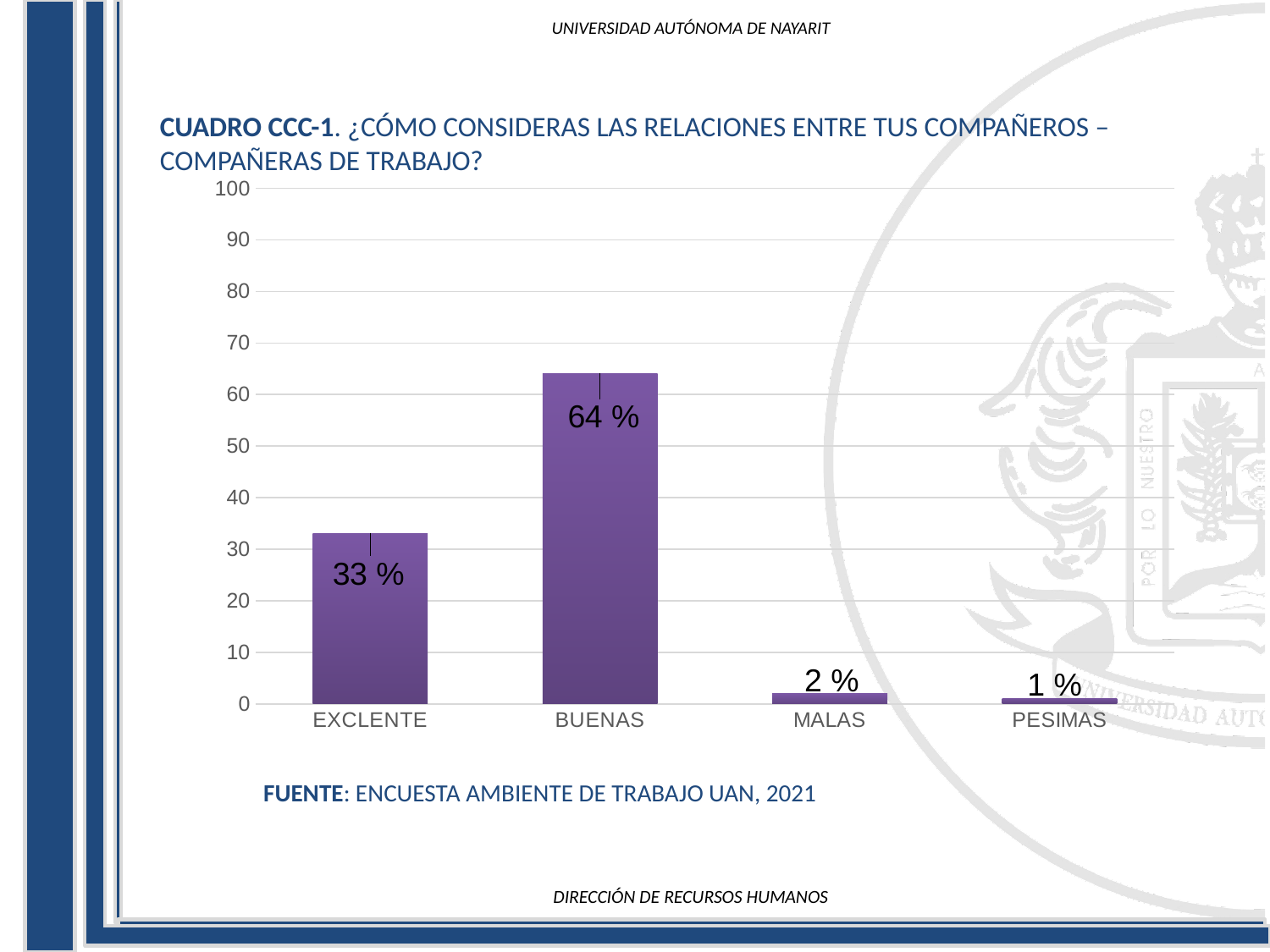
What is the value for MALAS? 2 % What source is cited below the chart? ENCUESTA AMBIENTE DE TRABAJO UAN, 2021 What is the value for EXCLENTE? 33 % What is the difference between the values for BUENAS and EXCLENTE? 31 % What kind of chart is shown on the slide? bar chart How many categories are shown on the x axis? 4 What is the value for PESIMAS? 1 % Which category has the highest value? BUENAS What is the value for BUENAS? 64 % Which category has the lowest value? PESIMAS Which is larger, the value for EXCLENTE or the value for MALAS? EXCLENTE Is the value for BUENAS greater or less than 50? greater